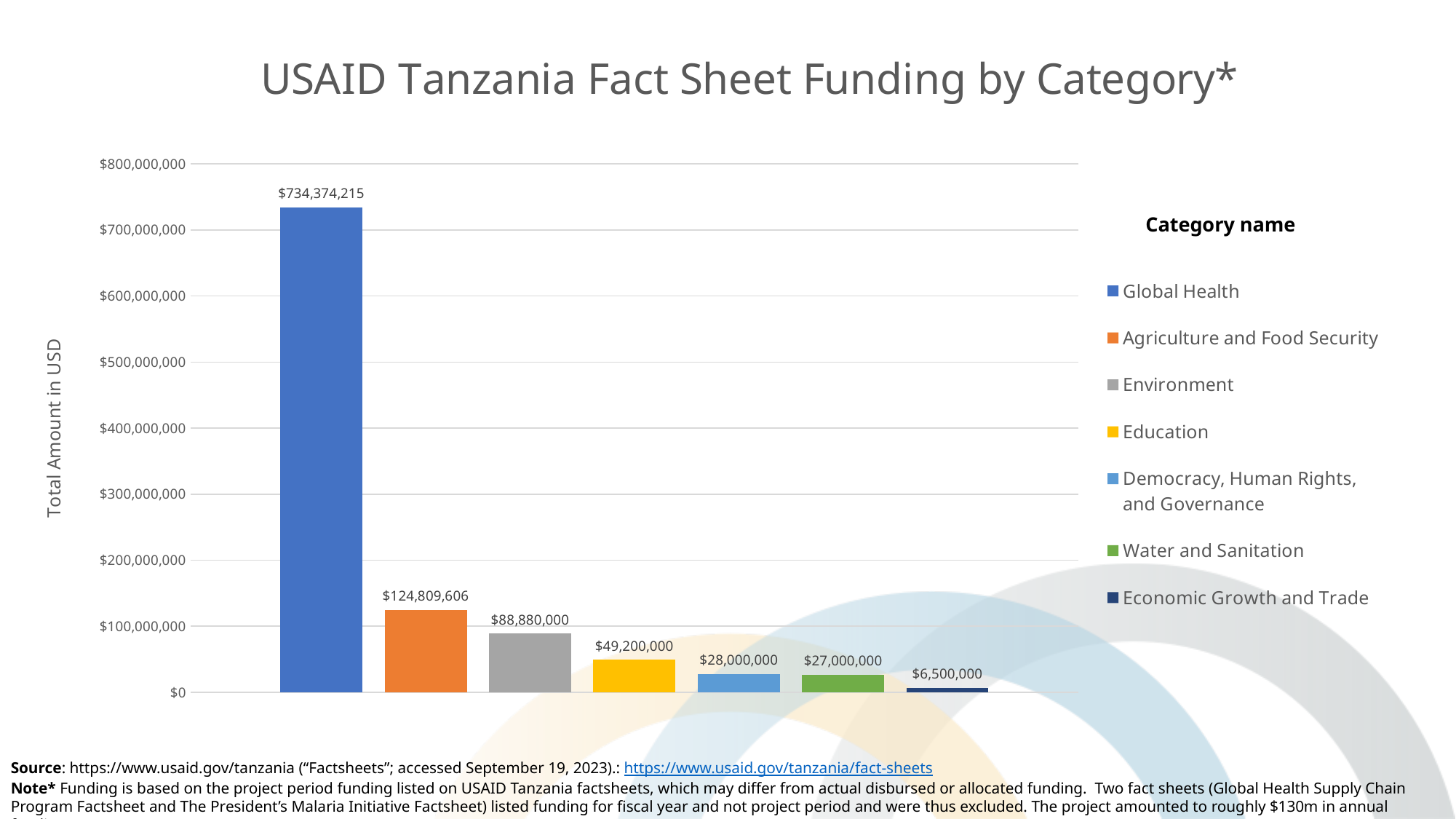
What is the funding amount for Education? $49,200,000 What is the difference in funding between Environment and Education? $39,680,000 Which category has the lowest funding? Economic Growth and Trade What type of chart is shown on the slide? Bar chart How many categories are shown in the chart? 7 What is the funding amount for Economic Growth and Trade? $6,500,000 What is the funding amount for Agriculture and Food Security? $124,809,606 Which category has the highest funding? Global Health What is the funding amount for Global Health? $734,374,215 What is the difference in funding between Global Health and Agriculture and Food Security? $609,564,609 Which has more funding, Environment or Water and Sanitation? Environment Is the value for Agriculture and Food Security greater or less than $100,000,000? greater